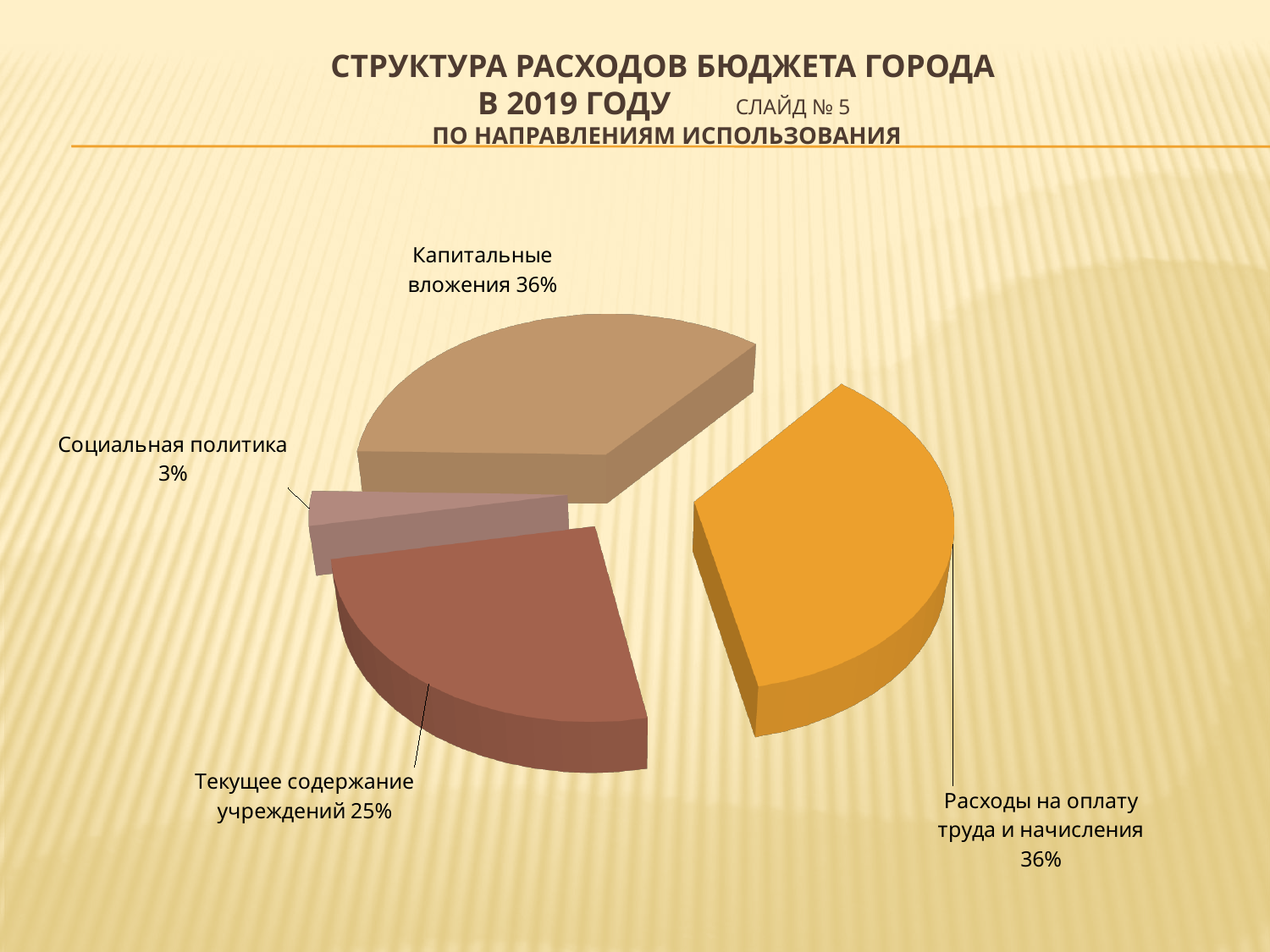
What share of the pie is Текущее содержание учреждений? 25% Which category has the smallest share of the pie? Социальная политика What is the difference in percentage points between Текущее содержание учреждений and Социальная политика? 22 What year does the chart title say the budget expenditure structure refers to? 2019 What share of the pie is Расходы на оплату труда и начисления? 36% What is the difference in percentage points between Капитальные вложения and Текущее содержание учреждений? 11 How many slices does the pie chart have? 4 Which is larger: the share for Текущее содержание учреждений or the share for Социальная политика? Текущее содержание учреждений What share of the pie is Капитальные вложения? 36% What kind of chart is shown on the slide? Pie chart Which is larger: the share for Капитальные вложения or the share for Текущее содержание учреждений? Капитальные вложения